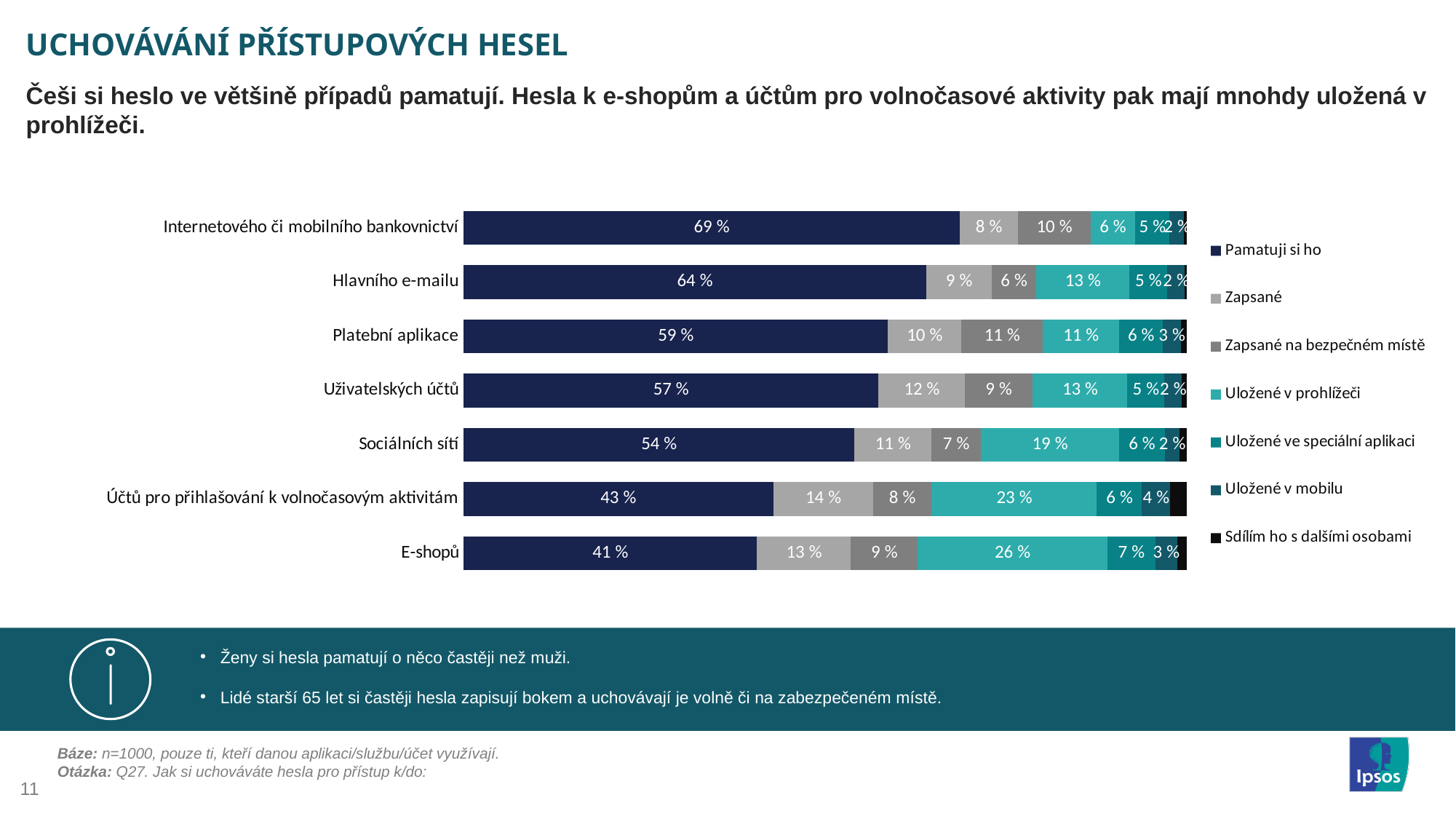
What is the value of 'Zapsané' for 'Účtů pro přihlašování k volnočasovým aktivitám'? 14 % Which is larger: the 'Uložené v prohlížeči' value for 'Platební aplikace' or for 'Uživatelských účtů'? Uživatelských účtů How many categories (types of accounts) are shown on the chart? 7 What kind of chart is shown on the slide? Stacked bar chart What is the value of 'Uložené v prohlížeči' for 'Sociálních sítí'? 19 % What is the value of 'Uložené v prohlížeči' for 'E-shopů'? 26 % Which category has the highest value for 'Pamatuji si ho'? Internetového či mobilního bankovnictví Which category has the lowest value for 'Pamatuji si ho'? E-shopů How many series does the legend list? 7 What is the difference between the 'Pamatuji si ho' values for 'Hlavního e-mailu' and 'Sociálních sítí'? 10 % Which legend entry is shown in black? Sdílím ho s dalšími osobami What is the value of 'Pamatuji si ho' for 'Internetového či mobilního bankovnictví'? 69 %